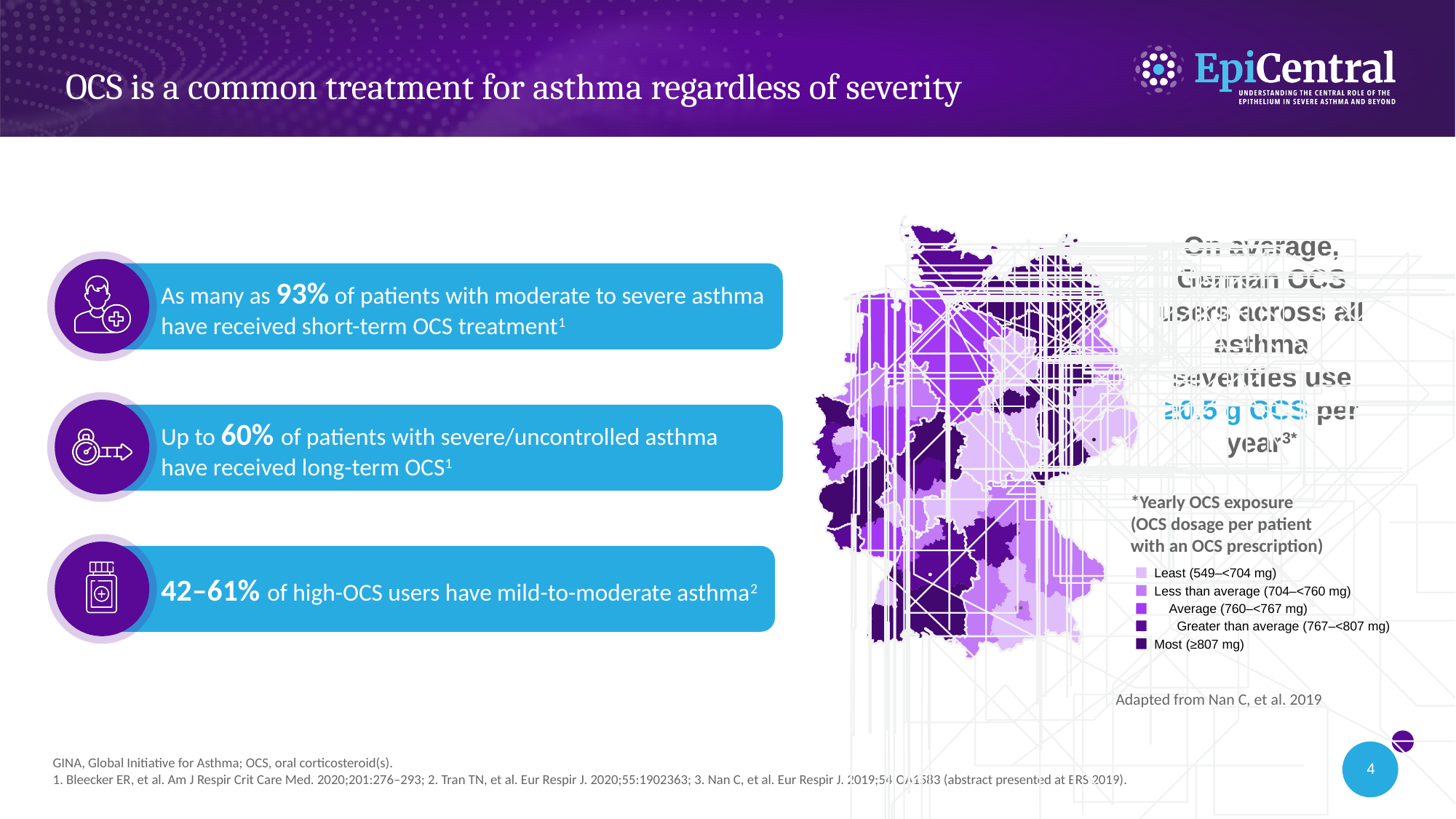
How many exposure categories does the map legend list? 5 On the map legend, what dosage range is labelled "Least"? 549–<704 mg Which legend category on the map has the lowest dosage range? Least (549–<704 mg) On the map legend, what dosage range is labelled "Greater than average"? 767–<807 mg On the map legend, what dosage range is labelled "Most"? ≥807 mg Which legend category on the map has the highest dosage range? Most (≥807 mg) What kind of chart is shown on the right of the slide? A map (choropleth map of Germany) According to the legend heading, what does the map show? Yearly OCS exposure (OCS dosage per patient with an OCS prescription) Which legend category is shown in the darkest purple on the map? Most (≥807 mg) On the map legend, what dosage range is labelled "Average"? 760–<767 mg On the map legend, what dosage range is labelled "Less than average"? 704–<760 mg